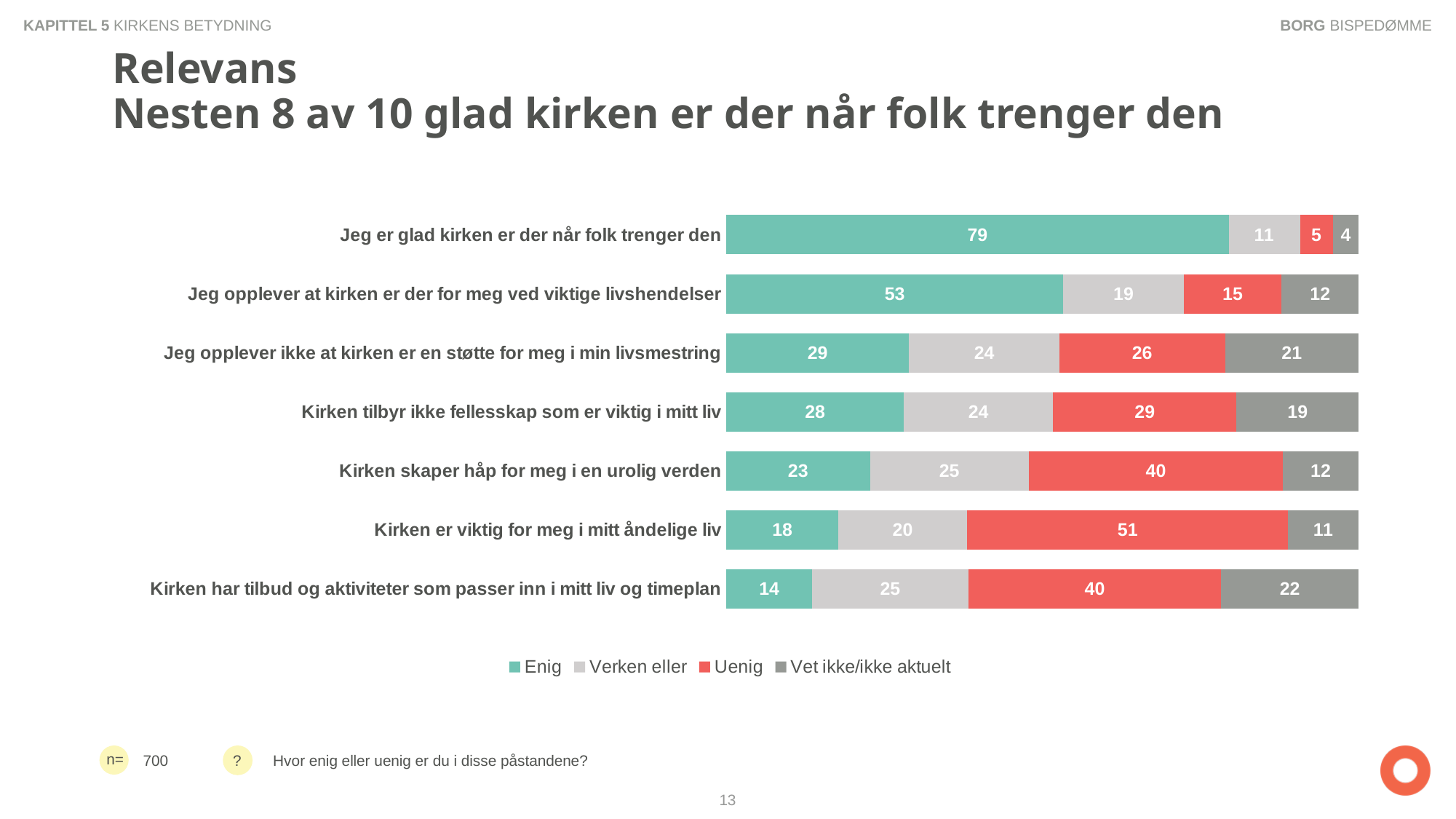
What is the Enig value for "Jeg er glad kirken er der når folk trenger den"? 79 What is the Uenig value for "Kirken er viktig for meg i mitt åndelige liv"? 51 Which has the larger Uenig value: "Kirken skaper håp for meg i en urolig verden" or "Kirken tilbyr ikke fellesskap som er viktig i mitt liv"? Kirken skaper håp for meg i en urolig verden What kind of chart is shown on the slide? Stacked bar chart Which statement has the lowest Enig value? Kirken har tilbud og aktiviteter som passer inn i mitt liv og timeplan How many series does the legend list? 4 Which statement has the highest Enig value? Jeg er glad kirken er der når folk trenger den Which colour represents Uenig in the chart? Red How many statements are shown in the chart? 7 What is the Vet ikke/ikke aktuelt value for "Kirken har tilbud og aktiviteter som passer inn i mitt liv og timeplan"? 22 What is the difference between the Enig values for "Jeg er glad kirken er der når folk trenger den" and "Jeg opplever at kirken er der for meg ved viktige livshendelser"? 26 What is the total of the stacked bar for "Jeg opplever ikke at kirken er en støtte for meg i min livsmestring"? 100